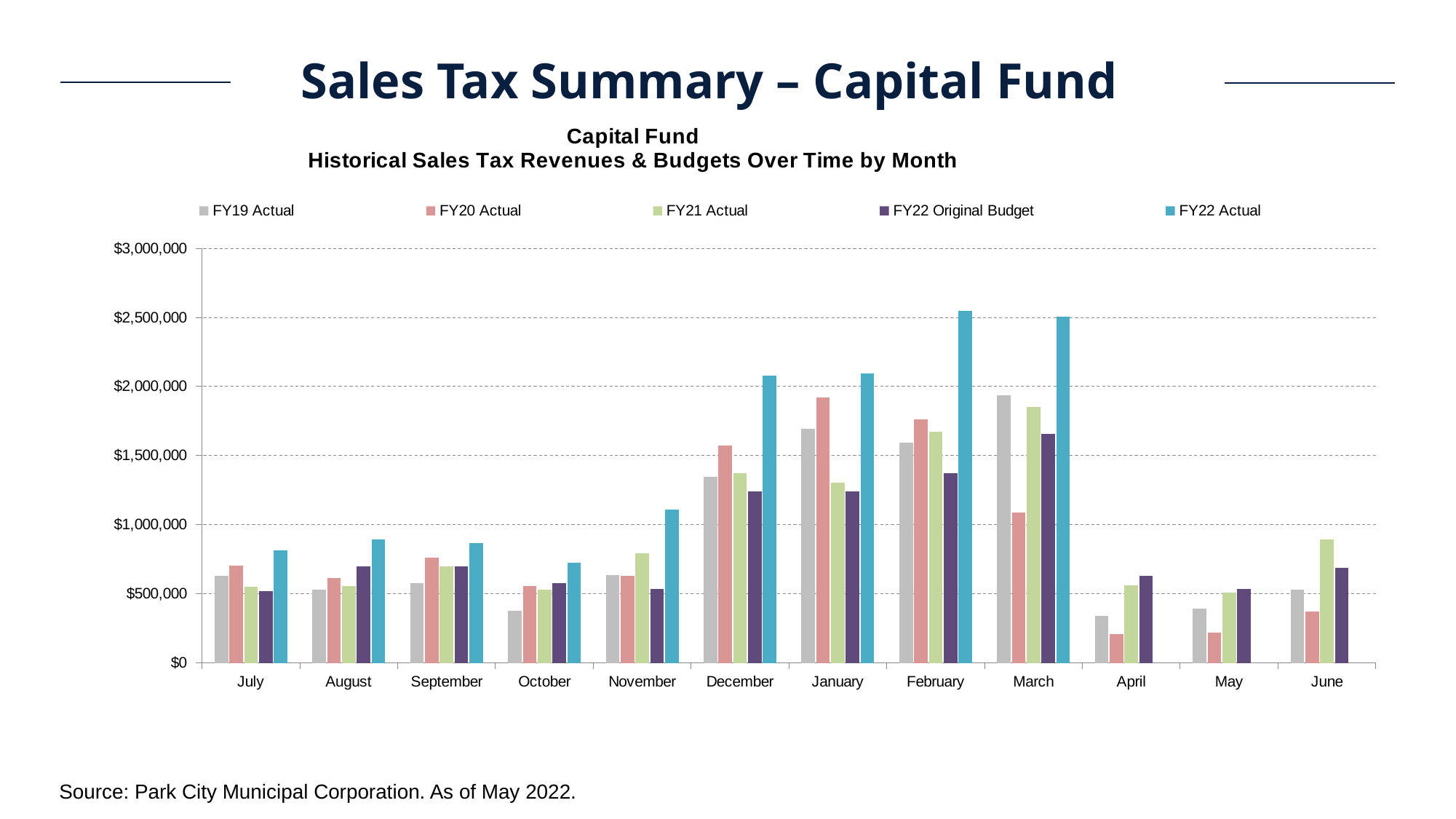
What is the source cited for the chart? Park City Municipal Corporation. As of May 2022. Is the FY22 Actual value for November greater or less than $1,000,000? greater Is the FY20 Actual value for April greater or less than $500,000? less In December, which is larger: FY22 Actual or FY19 Actual? FY22 Actual Which month has the highest FY20 Actual value? January How many series does the legend list? 5 In March, which is larger: FY20 Actual or FY21 Actual? FY21 Actual Which month has the highest FY22 Original Budget value? March Is the FY22 Actual value for February greater or less than $2,500,000? greater How many months are shown on the x axis? 12 What kind of chart is shown on the slide? bar chart Which month has the highest FY19 Actual value? March